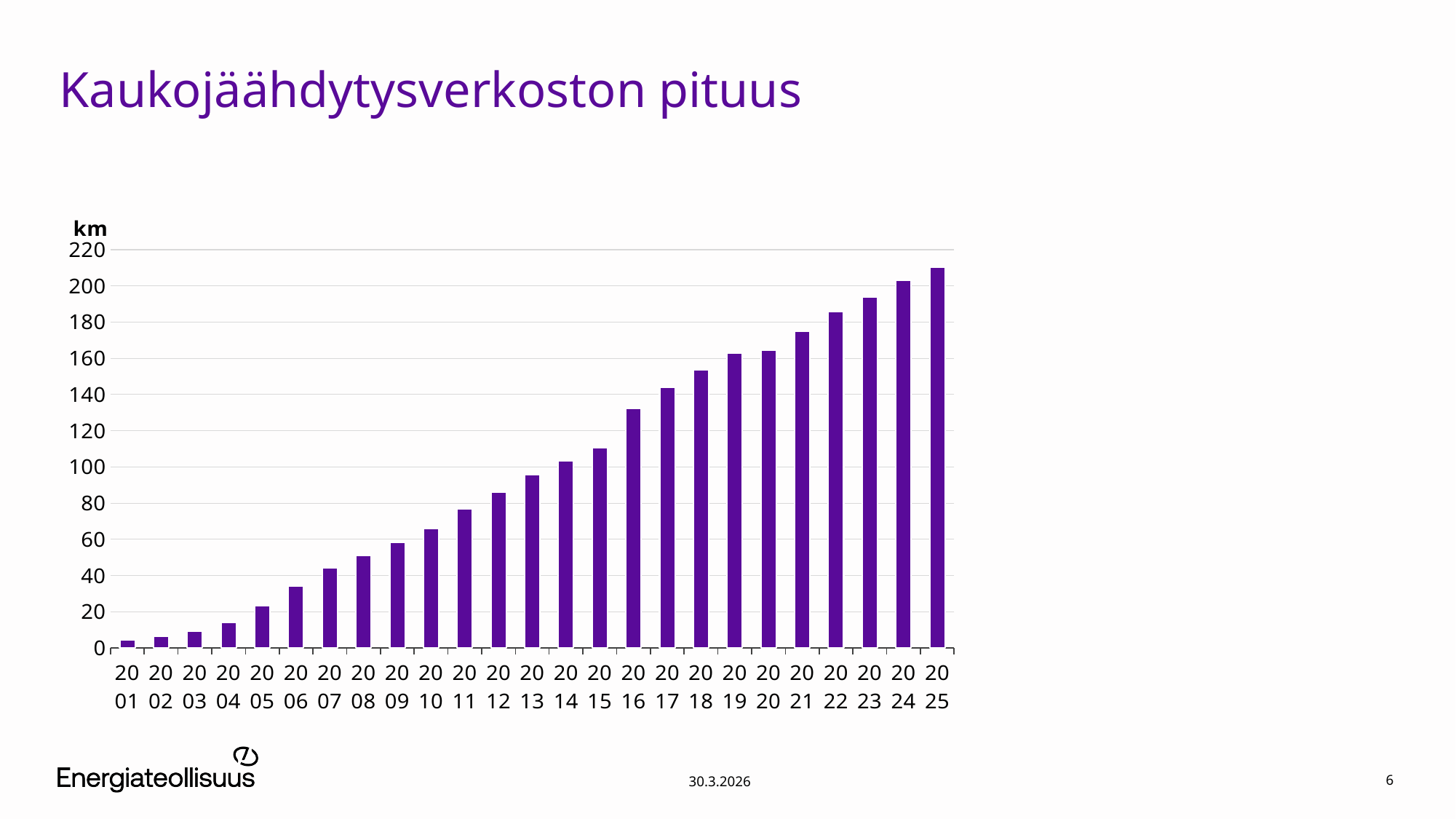
Which year has the lowest value in the chart? 2001 Which year has a larger value, 2010 or 2018? 2018 Do the values rise or fall from 2001 to 2025? rise Is the value for 2013 greater or less than 100? less Is the value for 2016 greater or less than 120? greater How many years (bars) are plotted in the chart? 25 Is the value for 2025 greater or less than 200? greater What unit is shown on the vertical axis? km What is the title of the chart? Kaukojäähdytysverkoston pituus What type of chart is shown on the slide? bar chart Which year has the highest value in the chart? 2025